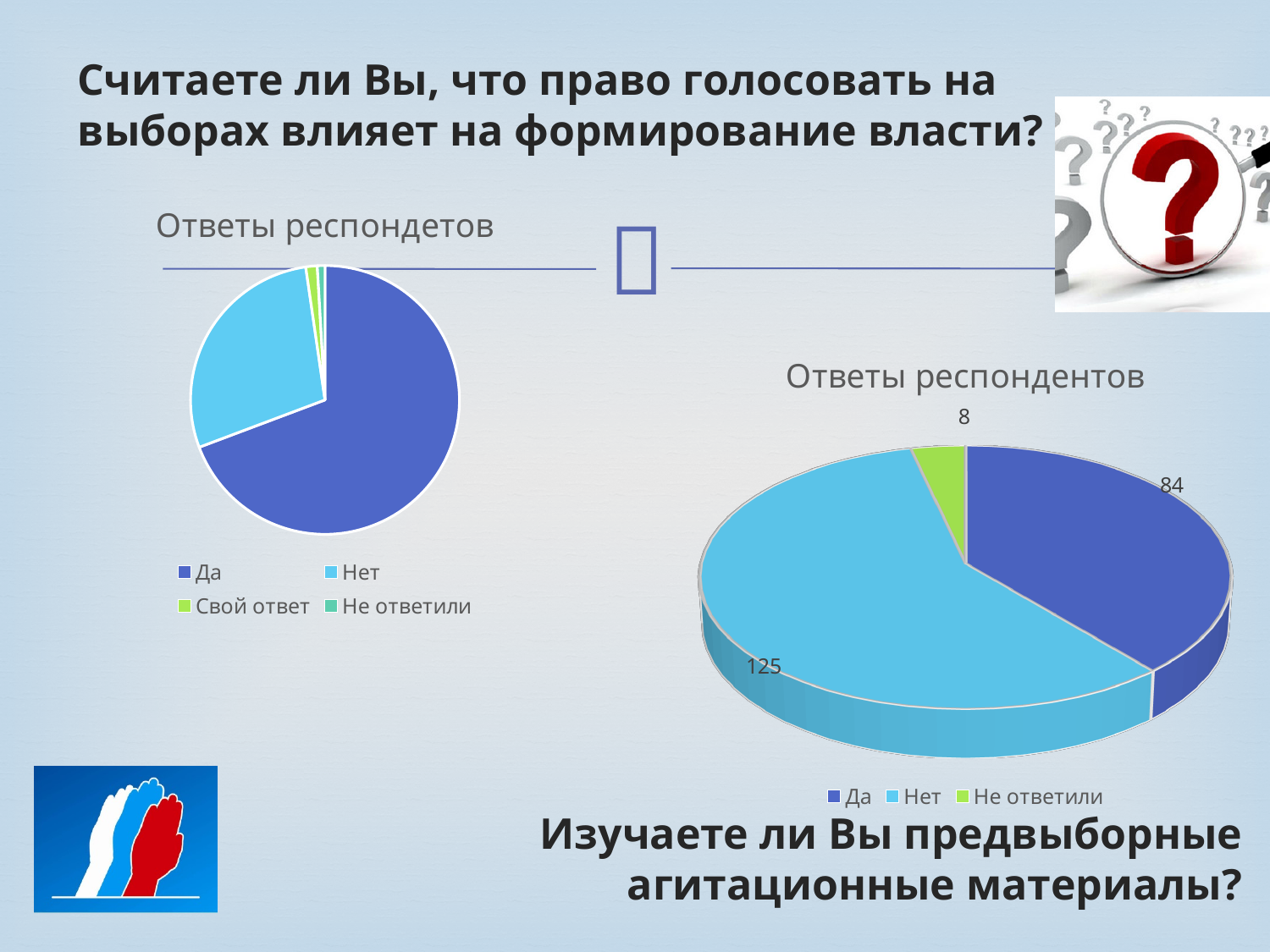
How many categories does the legend of the pie chart on the right list? 3 In the pie chart on the right, which category has the largest value? Нет In the pie chart on the right, which category has the smallest value? Не ответили In the pie chart on the right, what is the difference between the values for Нет and Да? 41 In the pie chart on the right, what is the total of all three values? 217 In the pie chart on the right, which is larger, Да or Нет? Нет What kind of chart is the chart on the left? Pie chart In the pie chart on the right, what is the value for Нет? 125 In the pie chart on the left, which category has the largest slice? Да In the pie chart on the right, what is the value for Не ответили? 8 How many categories does the legend of the pie chart on the left list? 4 In the pie chart on the right, what is the value for Да? 84